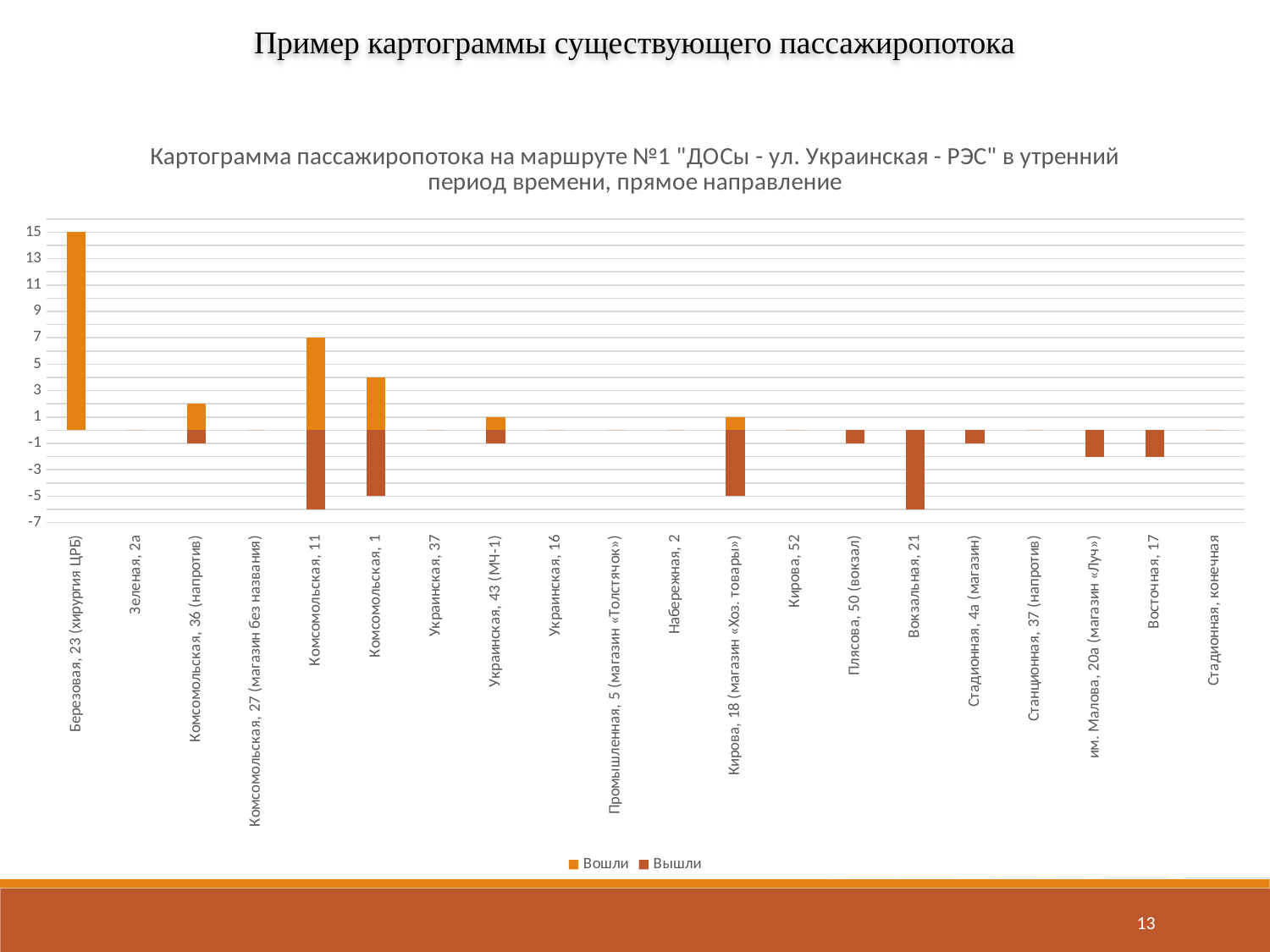
What kind of chart is shown on the slide? bar chart Which has the larger Вошли value, Комсомольская, 11 or Комсомольская, 1? Комсомольская, 11 What is the Вышли value for Комсомольская, 1? -5 What is the Вошли value for Комсомольская, 11? 7 How many stops (categories) are shown on the x axis? 20 What is the Вышли value for Кирова, 18 (магазин «Хоз. товары»)? -5 What are the two series named in the legend? Вошли and Вышли How many series does the legend list? 2 What is the Вошли value for Березовая, 23 (хирургия ЦРБ)? 15 Is the Вошли value for Комсомольская, 1 greater or less than 3? greater Is the Вышли value for Вокзальная, 21 greater or less than -5? less Which stop has the highest value for Вошли? Березовая, 23 (хирургия ЦРБ)